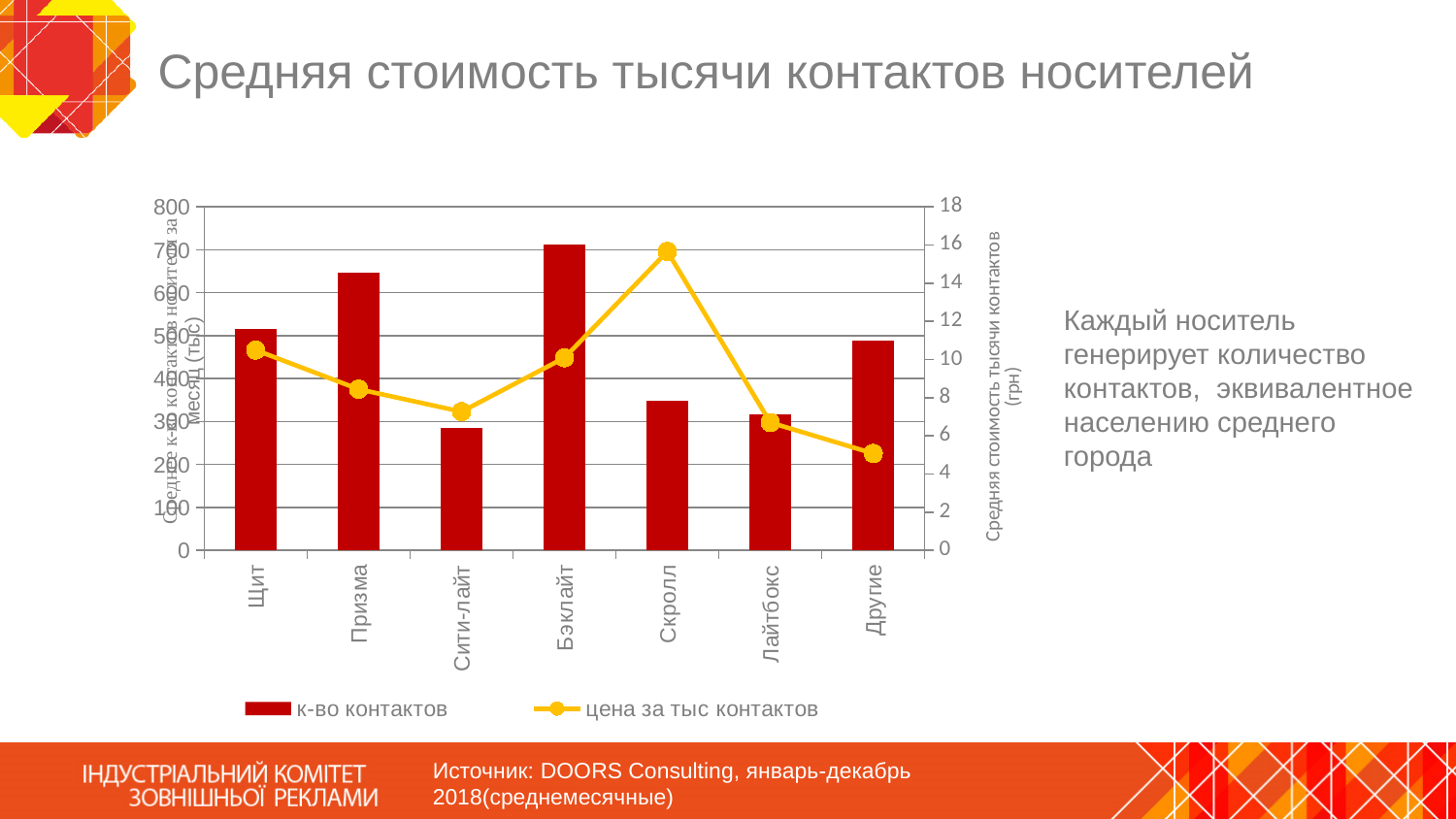
Which category has the lowest point on the 'цена за тыс контактов' line? Другие Which category has the highest bar for 'к-во контактов'? Бэклайт Which has a higher 'к-во контактов' bar, Щит or Лайтбокс? Щит How many series does the chart legend list? 2 Which category has the lowest bar for 'к-во контактов'? Сити-лайт Is the 'к-во контактов' bar for Призма greater or less than 600? greater What are the two series named in the chart legend? к-во контактов and цена за тыс контактов Is the 'к-во контактов' bar for Скролл greater or less than 400? less Which category has the highest point on the 'цена за тыс контактов' line? Скролл What kind of chart is shown on the slide? Combined bar and line chart Is the 'цена за тыс контактов' value for Скролл greater or less than 14? greater How many categories are shown on the x axis of the chart? 7